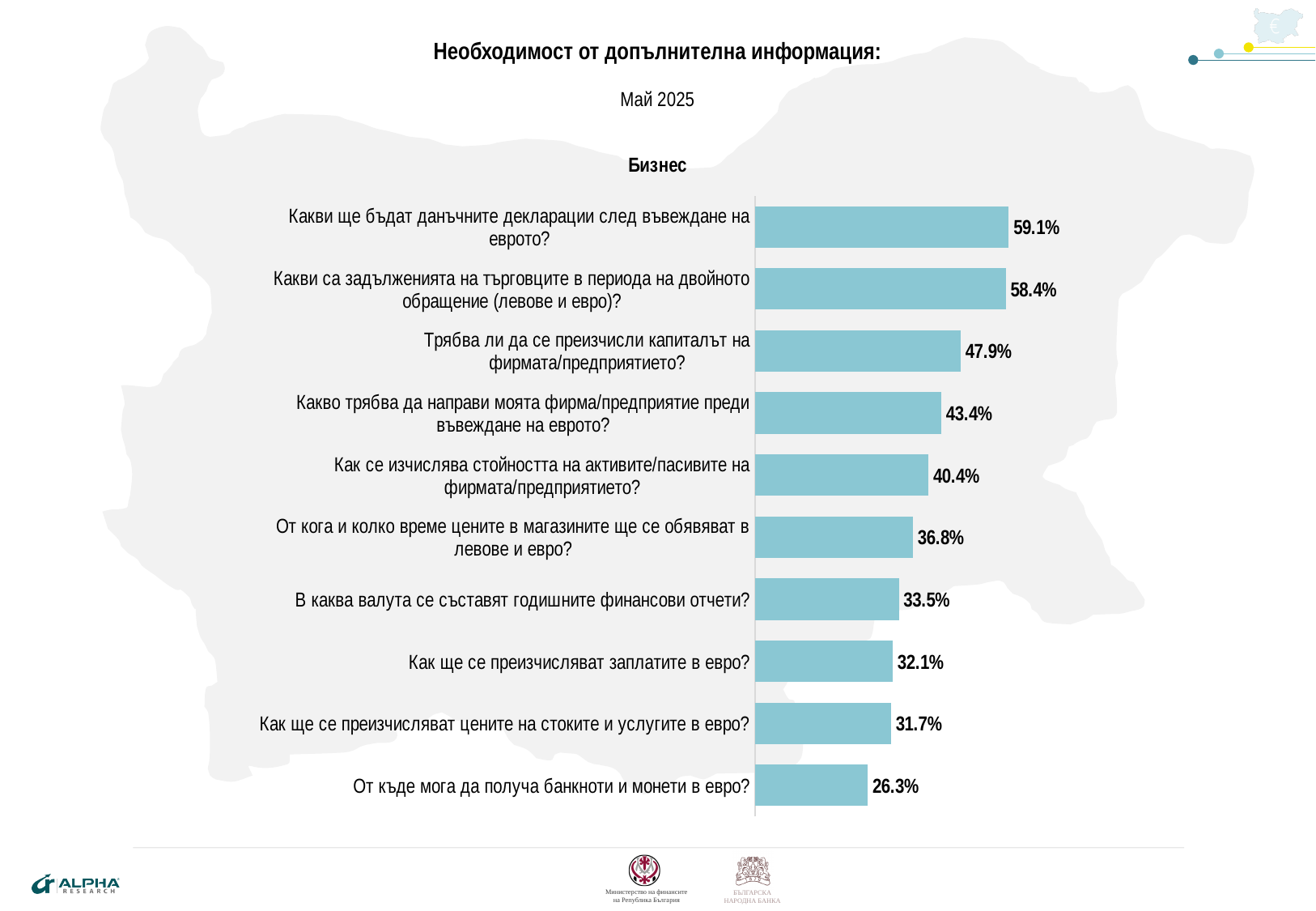
What is the title of the chart? Необходимост от допълнителна информация: Май 2025 Which category has the lowest value? От къде мога да получа банкноти и монети в евро? What kind of chart is shown on the slide? Bar chart What is the difference between the highest and lowest values in the chart? 32.8% What is the value for "Как ще се преизчисляват заплатите в евро?"? 32.1% Which category has the highest value? Какви ще бъдат данъчните декларации след въвеждане на еврото? Which is larger: the value for "Как се изчислява стойността на активите/пасивите на фирмата/предприятието?" or the value for "От кога и колко време цените в магазините ще се обявяват в левове и евро?"? Как се изчислява стойността на активите/пасивите на фирмата/предприятието? Which group does the chart refer to, according to the subtitle above the bars? Бизнес What is the value for "Какви ще бъдат данъчните декларации след въвеждане на еврото?"? 59.1% How many categories are shown in the chart? 10 What is the value for "В каква валута се съставят годишните финансови отчети?"? 33.5% What is the difference between the values for "Трябва ли да се преизчисли капиталът на фирмата/предприятието?" and "Какво трябва да направи моята фирма/предприятие преди въвеждане на еврото?"? 4.5%